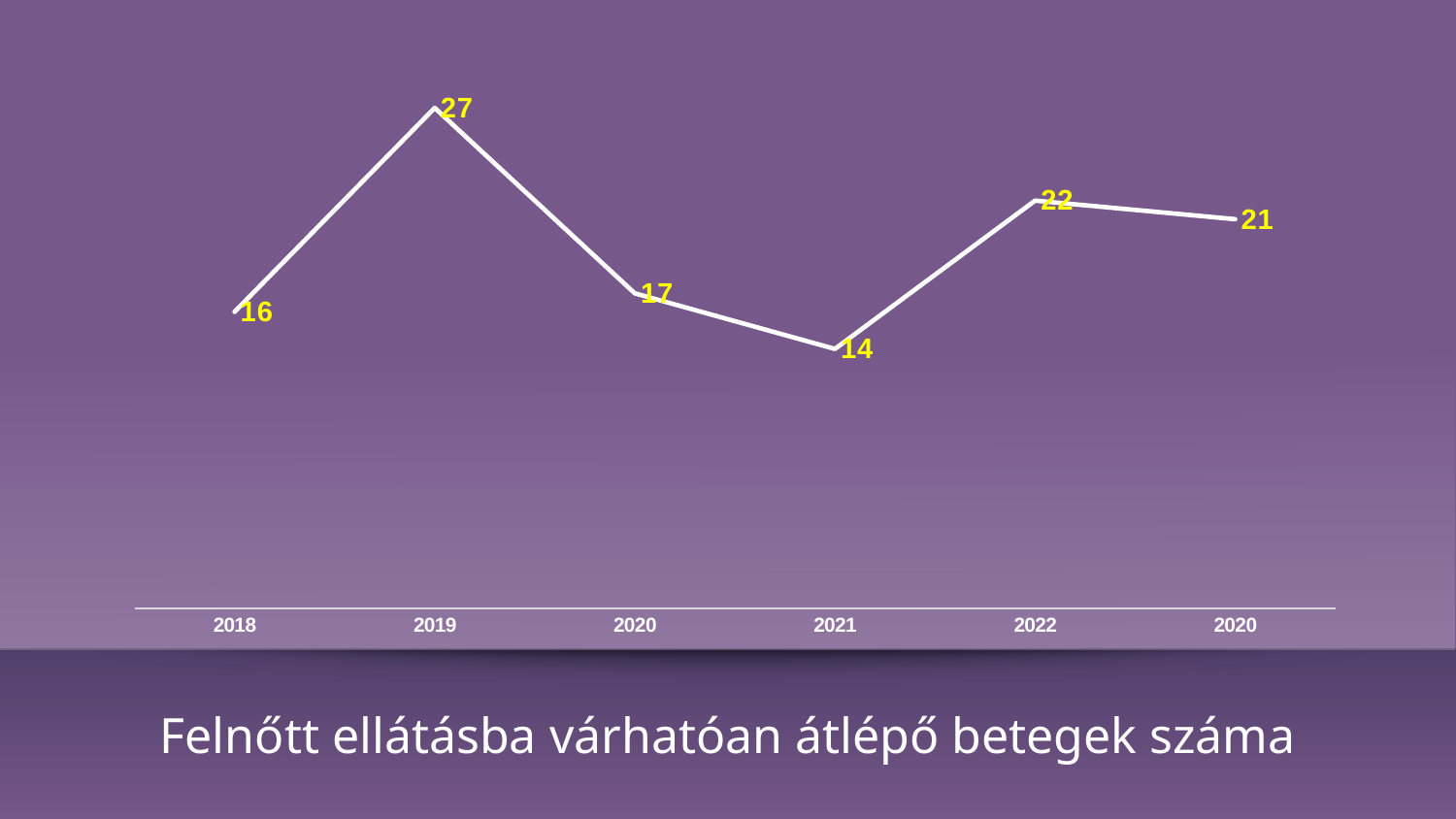
What is the value for 2022? 22 What kind of chart is shown on the slide? line chart What is the value for 2019? 27 What is the value for 2018? 16 Which year has the highest value? 2019 What is the difference between the values for 2022 and 2018? 6 What is the value of the last (rightmost) point on the line? 21 Which is larger, the value for 2018 or the value for 2022? 2022 What is the value for 2021? 14 How many data points are plotted on the line? 6 Which year has the lowest value? 2021 What is the difference between the values for 2019 and 2021? 13